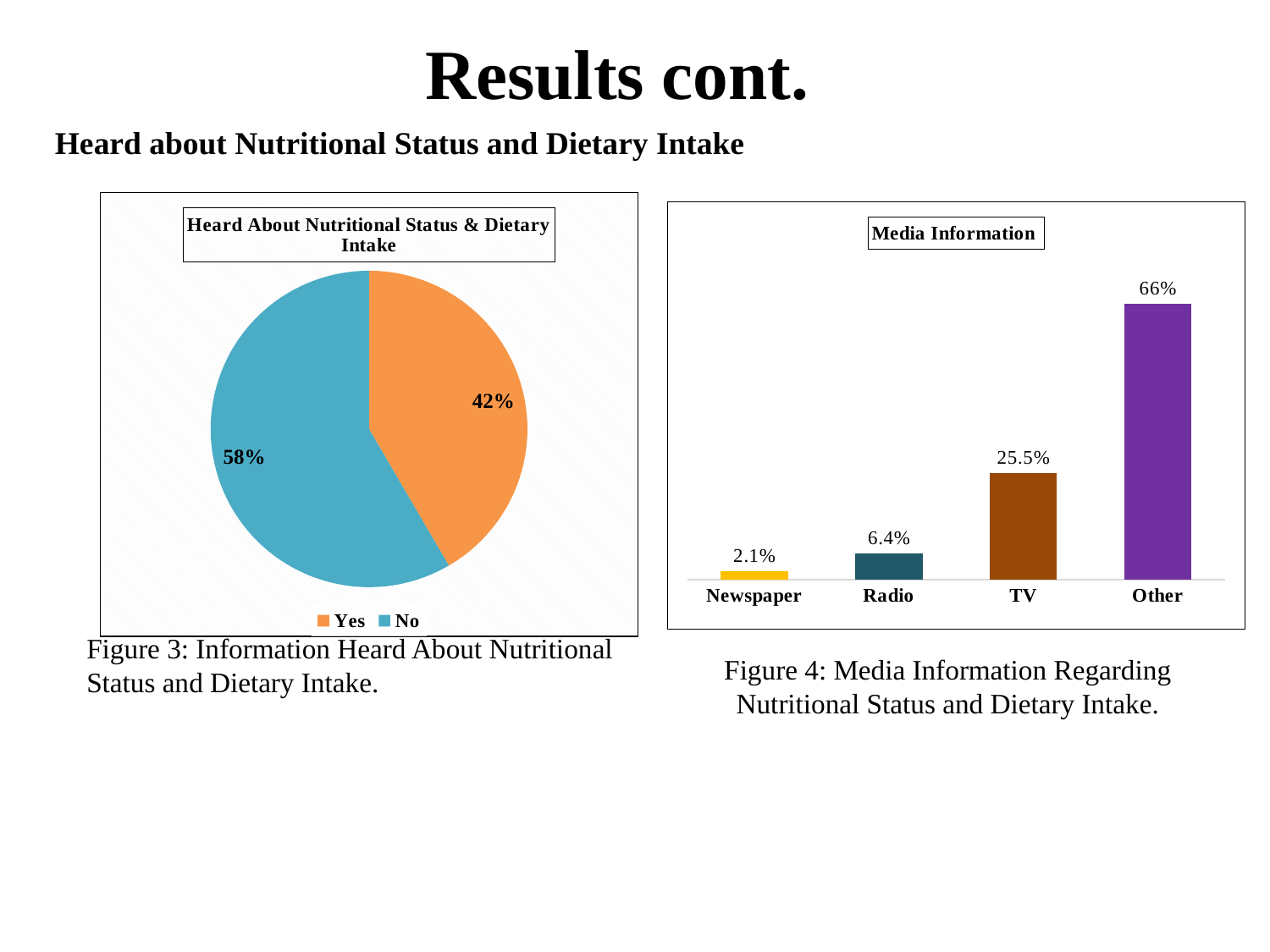
In the 'Media Information' chart, which category has the highest value? Other In the 'Heard About Nutritional Status & Dietary Intake' pie chart, what colour is the Yes slice? Orange In the 'Media Information' chart, what is the difference between the values for TV and Radio? 19.1% In the 'Heard About Nutritional Status & Dietary Intake' pie chart, what is the difference between the No and Yes percentages? 16% In the 'Media Information' chart, which category has the lowest value? Newspaper In the 'Media Information' chart, what is the value for TV? 25.5% In the 'Heard About Nutritional Status & Dietary Intake' pie chart, what percentage answered No? 58% How many categories are shown in the 'Media Information' chart? 4 In the 'Media Information' chart, what is the value for Newspaper? 2.1% In the 'Heard About Nutritional Status & Dietary Intake' pie chart, what percentage answered Yes? 42% In the 'Heard About Nutritional Status & Dietary Intake' pie chart, which slice is larger, Yes or No? No What type of chart is the 'Heard About Nutritional Status & Dietary Intake' chart? Pie chart